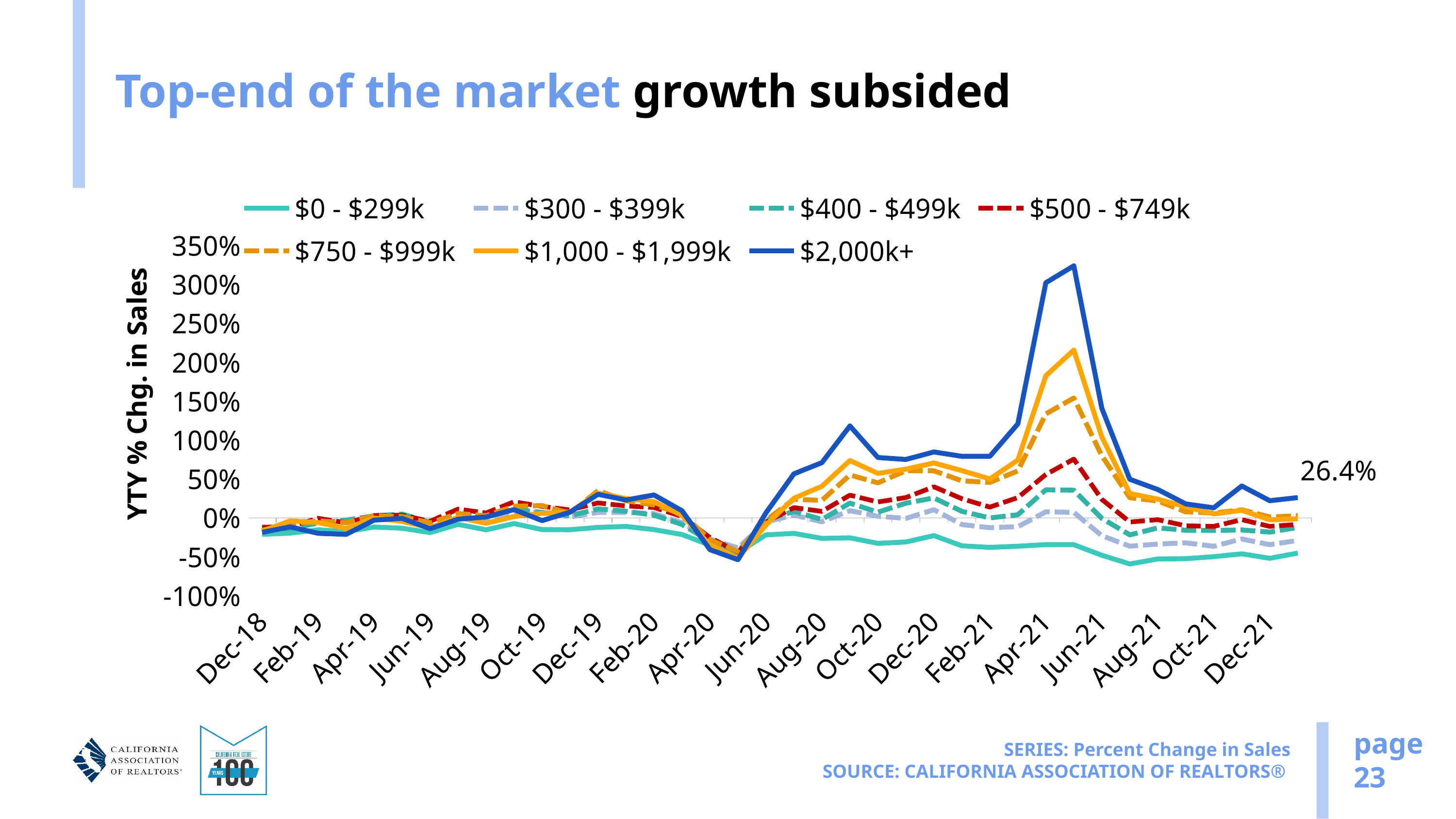
What is the title of the slide? Top-end of the market growth subsided What is the title of the y axis? YTY % Chg. in Sales Is the value for $0 - $299k at Aug-20 greater or less than 0%? less Is the value for $2,000k+ at its peak between Aug-20 and Oct-20 greater or less than 100%? greater How many series does the legend list? 7 Does the $2,000k+ line rise or fall from Jun-21 to Aug-21? fall What type of chart is shown on the slide? line chart What value is printed as a data label at the right end of the chart? 26.4% Is the peak value of the $2,000k+ series between Apr-21 and Jun-21 greater or less than 300%? greater Which series reaches the highest peak on the chart? $2,000k+ At Apr-21, which series is higher: $1,000 - $1,999k or $500 - $749k? $1,000 - $1,999k Which series has the lowest value at Dec-21? $0 - $299k